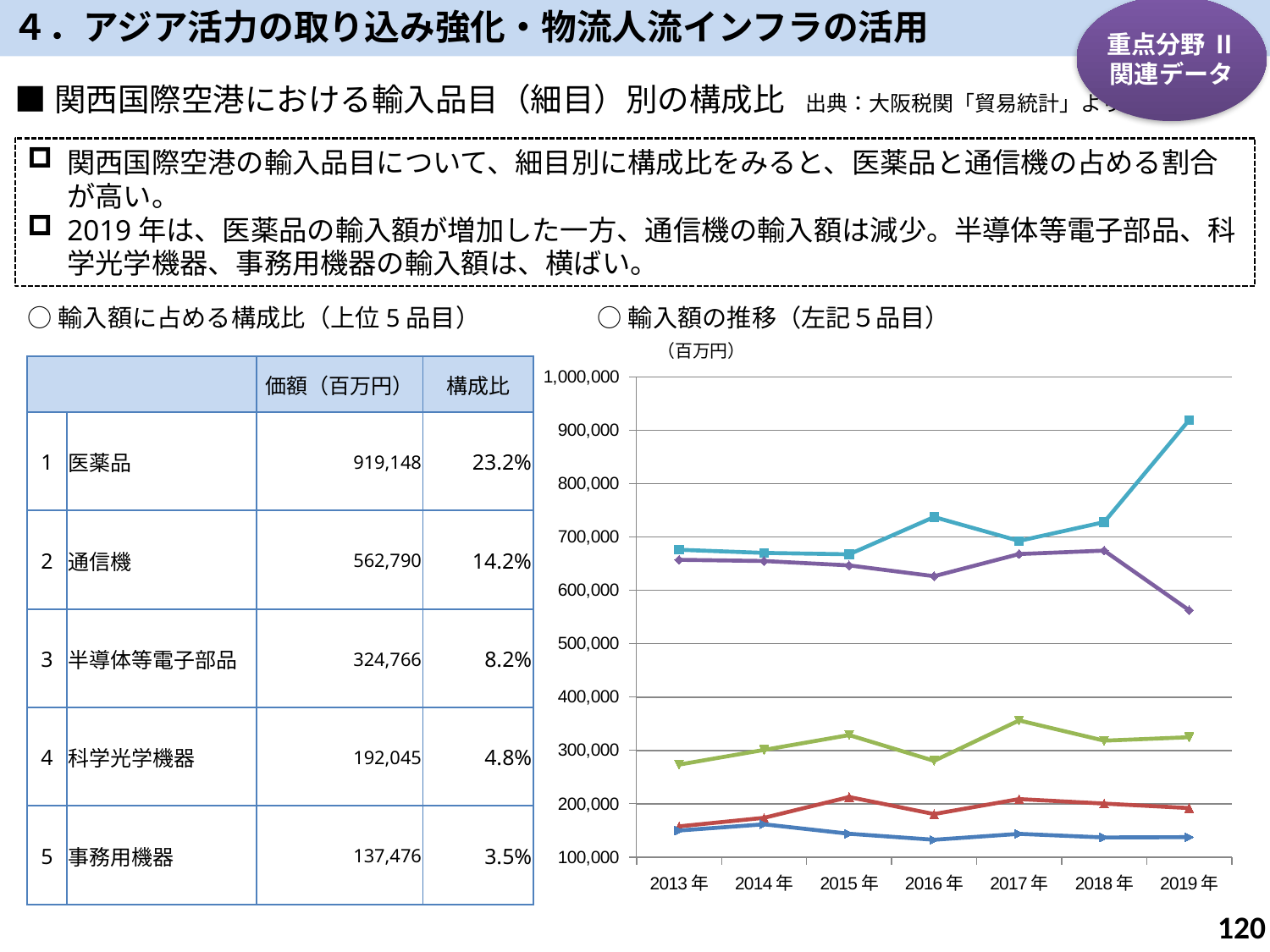
In the line chart 輸入額の推移, what unit is shown above the y axis? 百万円 In the line chart 輸入額の推移, which line has the highest value in 2019年? the light blue line In the line chart 輸入額の推移, does the light blue line rise or fall from 2018年 to 2019年? rise In the line chart 輸入額の推移, how many lines are plotted? 5 In the line chart 輸入額の推移, is the value of the dark blue line in 2013年 greater or less than 200,000? less What kind of chart is shown on the right side of the slide (輸入額の推移)? line chart In the line chart 輸入額の推移, is the value of the light blue line in 2019年 greater or less than 900,000? greater In the line chart 輸入額の推移, in 2019年 which is higher, the light blue line or the purple line? the light blue line In the line chart 輸入額の推移, does the purple line rise or fall from 2018年 to 2019年? fall In the line chart 輸入額の推移, is the value of the green line in 2013年 greater or less than 300,000? less In the line chart 輸入額の推移, how many years are shown on the x axis? 7